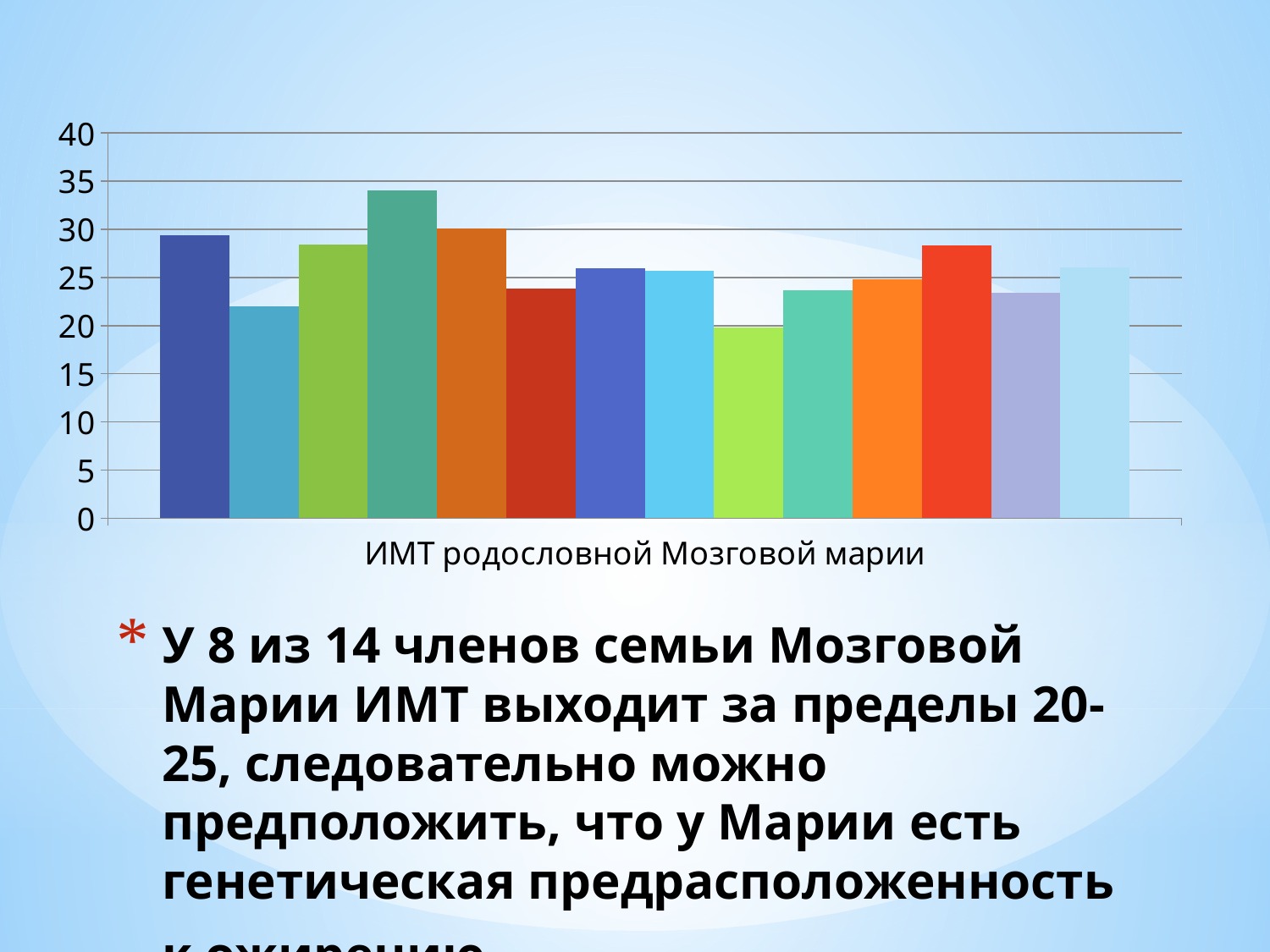
Is the value of the first bar from the left greater or less than 25? greater Which bar is the tallest in the chart, counting from the left? the fourth bar Is the value of the second bar from the left greater or less than 25? less Is the value of the fourth bar from the left greater or less than 30? greater How many bars are plotted in the chart? 14 Which is larger: the fourth bar from the left or the second bar from the left? the fourth bar Which bar is the shortest in the chart, counting from the left? the ninth bar Which is larger: the ninth bar from the left or the fifth bar from the left? the fifth bar What kind of chart is shown on the slide? bar chart What is the label shown under the horizontal axis of the chart? ИМТ родословной Мозговой марии